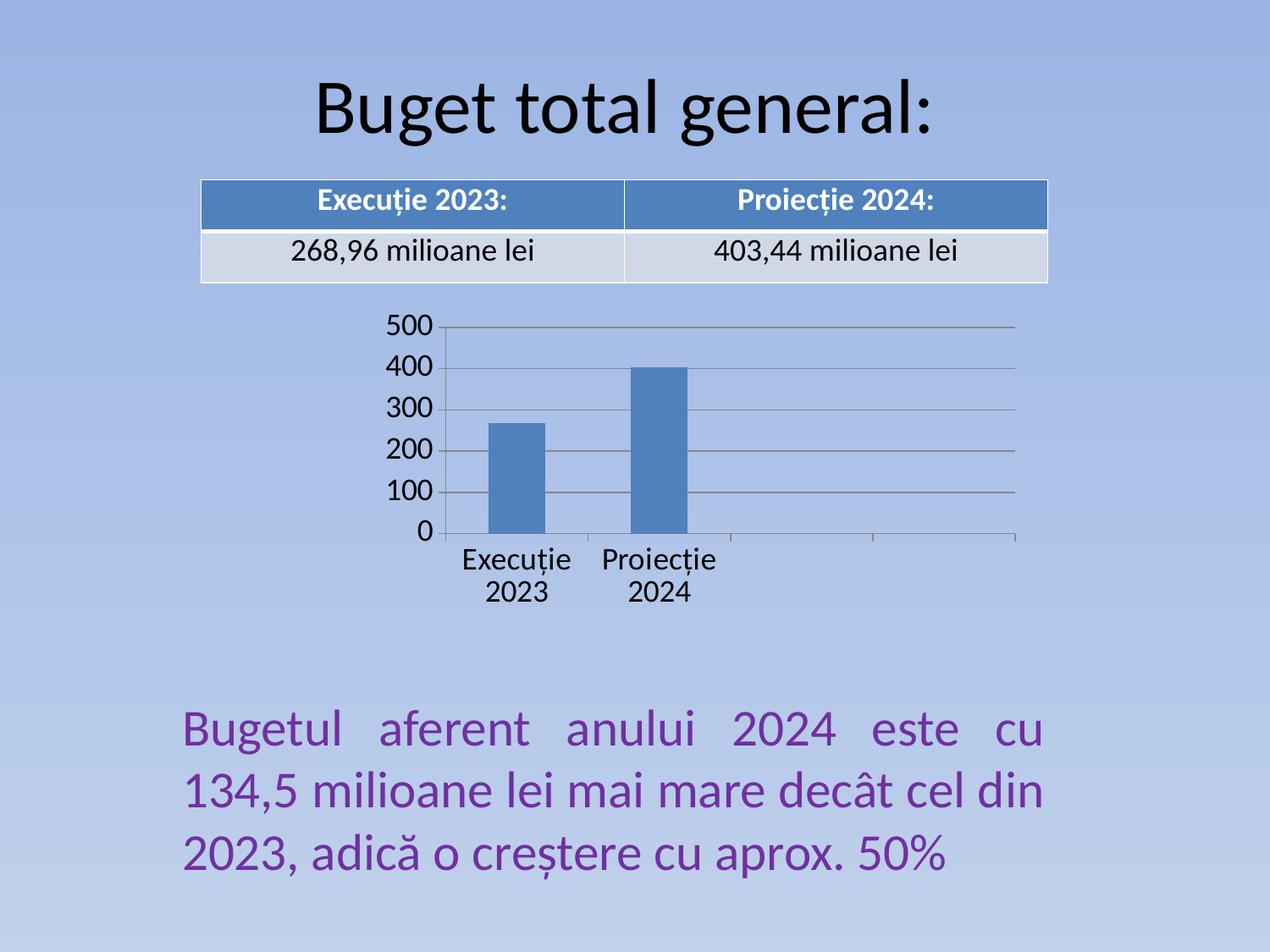
Is the value for Proiecție 2024 greater or less than 500? less Which category has the lowest bar in the chart? Execuție 2023 What is the title of the slide containing the chart? Buget total general: Is the value for Execuție 2023 greater or less than 200? greater Which category has the highest bar in the chart? Proiecție 2024 What is the highest tick value shown on the vertical axis of the chart? 500 What kind of chart is shown on the slide? bar chart Which is larger, the bar for Execuție 2023 or the bar for Proiecție 2024? Proiecție 2024 Do the values rise or fall from Execuție 2023 to Proiecție 2024? rise Is the value for Execuție 2023 greater or less than 300? less How many categories are plotted in the bar chart? 2